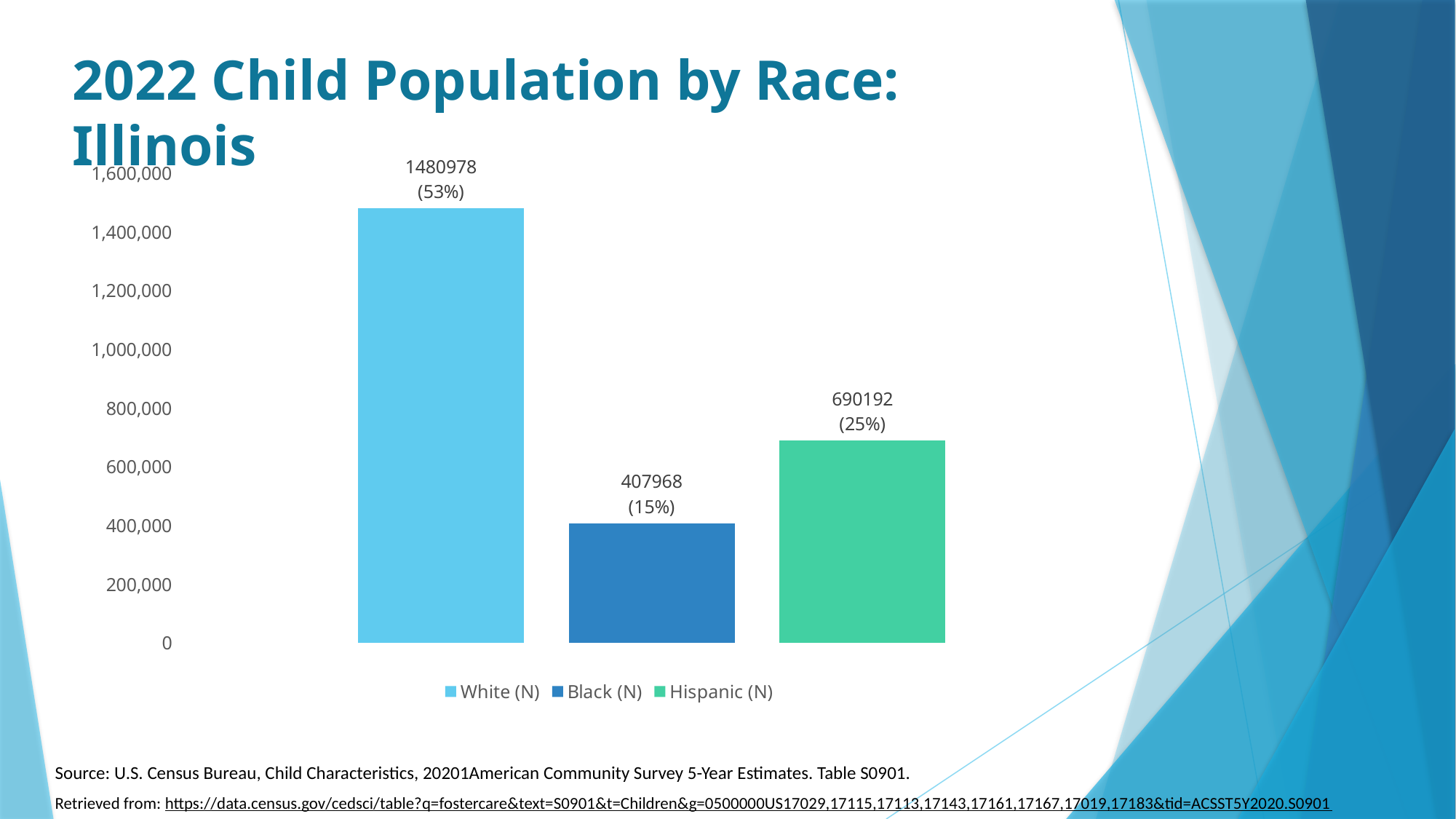
Which is larger, the value for Hispanic (N) or the value for Black (N)? Hispanic (N) What kind of chart is shown on the slide? Bar chart What is the difference between the values for Hispanic (N) and Black (N)? 282224 What is the value shown for Black (N)? 407968 How many bars are plotted in the chart? 3 Is the value for White (N) greater or less than 1,400,000? greater What is the difference between the values for White (N) and Hispanic (N)? 790786 How many entries does the legend list? 3 Which group has the highest child population? White (N) What percentage is shown for Hispanic (N)? 25% What is the value shown for White (N)? 1480978 Which group has the lowest child population? Black (N)